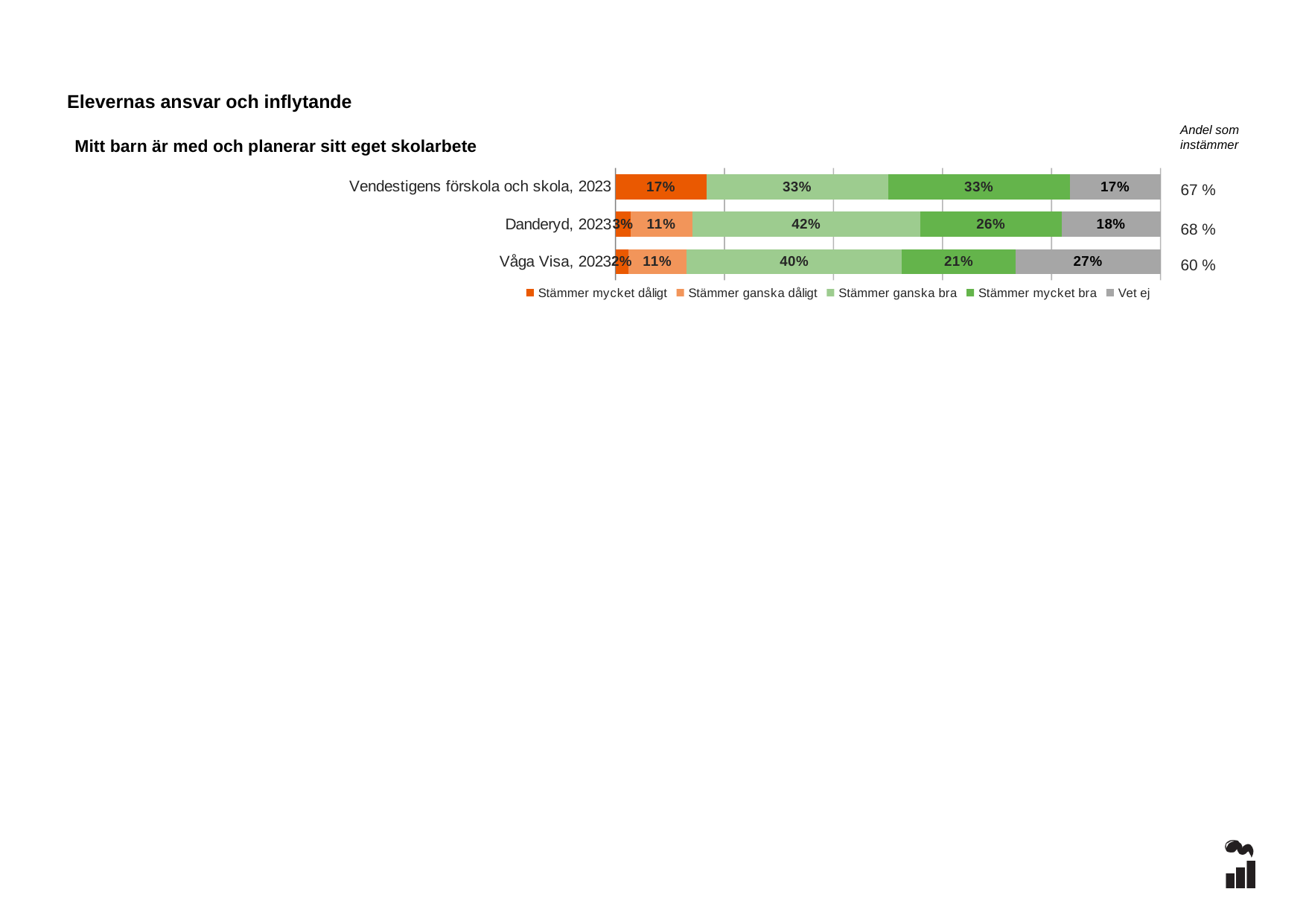
How many categories (bars) are shown in the chart? 3 What is the 'Stämmer mycket dåligt' value for Vendestigens förskola och skola, 2023? 17% Which is larger: the 'Stämmer mycket bra' value for Danderyd, 2023 or for Våga Visa, 2023? Danderyd, 2023 Which category has the lowest 'Vet ej' value? Vendestigens förskola och skola, 2023 What is the 'Vet ej' value for Våga Visa, 2023? 27% What kind of chart is shown on the slide? stacked bar chart What is the 'Andel som instämmer' figure shown for Danderyd, 2023? 68 % What is the difference between the 'Stämmer ganska bra' values for Danderyd, 2023 and Vendestigens förskola och skola, 2023? 9% Which category has the highest 'Stämmer mycket bra' value? Vendestigens förskola och skola, 2023 What is the 'Stämmer ganska bra' value for Danderyd, 2023? 42% How many series does the legend list? 5 What is the 'Stämmer mycket bra' value for Våga Visa, 2023? 21%